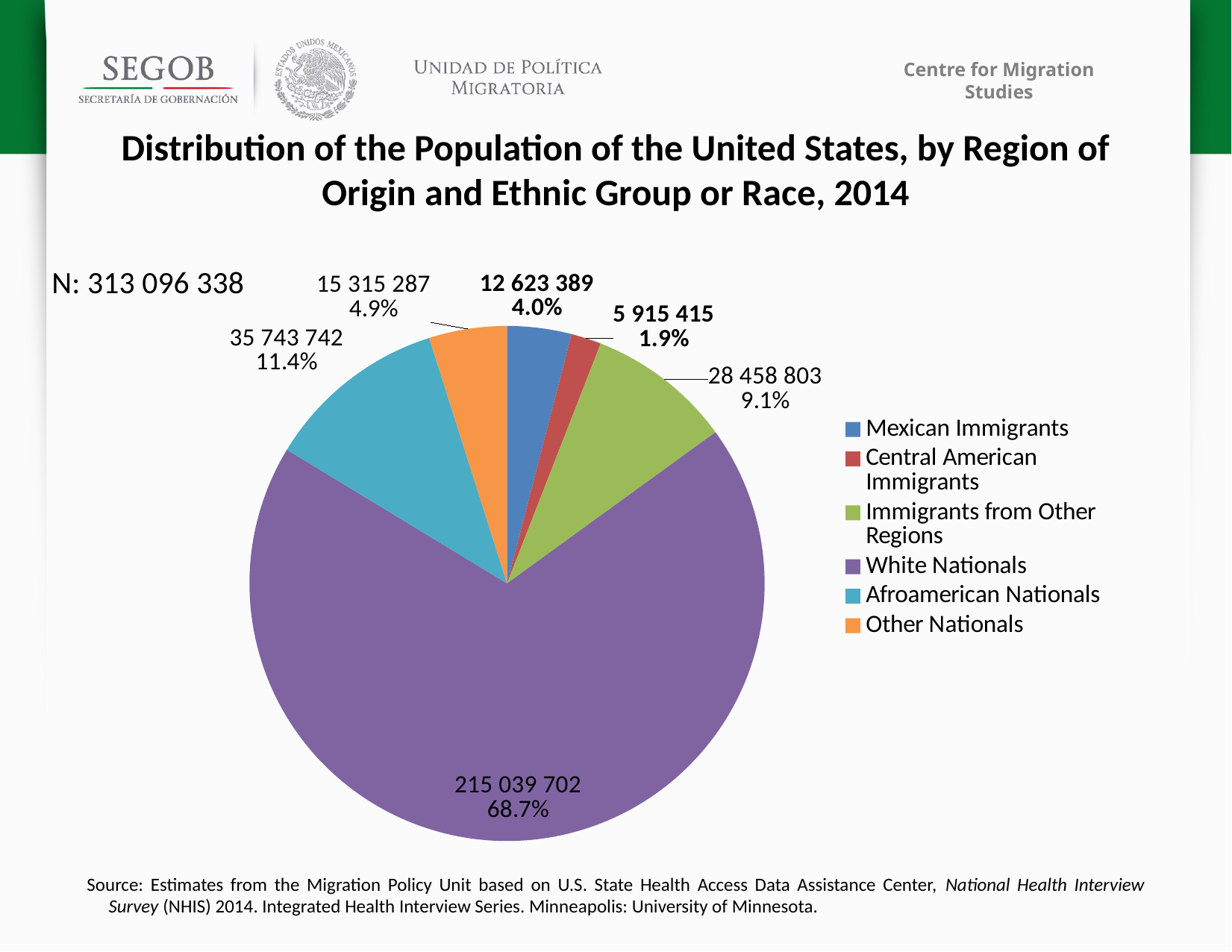
Which is larger, the slice for Immigrants from Other Regions or the slice for Other Nationals? Immigrants from Other Regions Which category has the largest slice of the pie? White Nationals What share of the pie do Central American Immigrants represent? 1.9% Which category has the smallest slice of the pie? Central American Immigrants What kind of chart is shown on the slide? Pie chart What is the population value shown for White Nationals? 215 039 702 What percentage of the pie is Afroamerican Nationals? 11.4% What total population (N) is stated on the slide? 313 096 338 What is the difference in percentage points between the Afroamerican Nationals share and the Immigrants from Other Regions share? 2.3 percentage points What is the population value shown for Mexican Immigrants? 12 623 389 What colour is the slice for Other Nationals? Orange How many slices does the pie chart have? 6